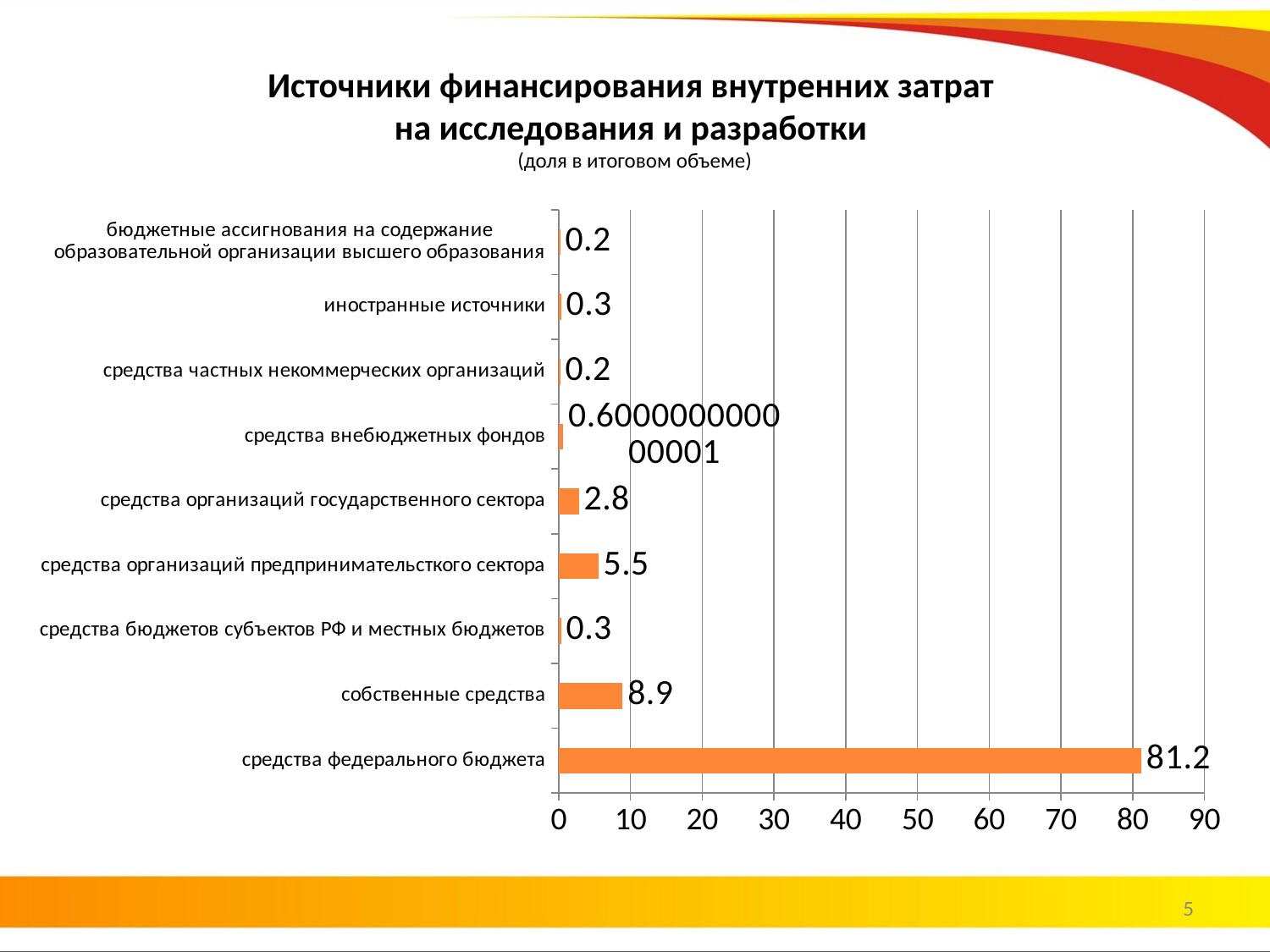
What is the value for иностранные источники? 0.3 How many categories are shown in the chart? 9 What is the value for средства организаций государственного сектора? 2.8 Which category has the highest value? средства федерального бюджета What kind of chart is shown on the slide? bar chart What is the value for средства федерального бюджета? 81.2 What is the value for собственные средства? 8.9 What is the title of the chart? Источники финансирования внутренних затрат на исследования и разработки What is the difference between the values for средства федерального бюджета and собственные средства? 72.3 Is the value for средства федерального бюджета greater or less than 80? greater Which is larger: собственные средства or средства организаций предпринимательского сектора? собственные средства What is the value for средства организаций предпринимательского сектора? 5.5